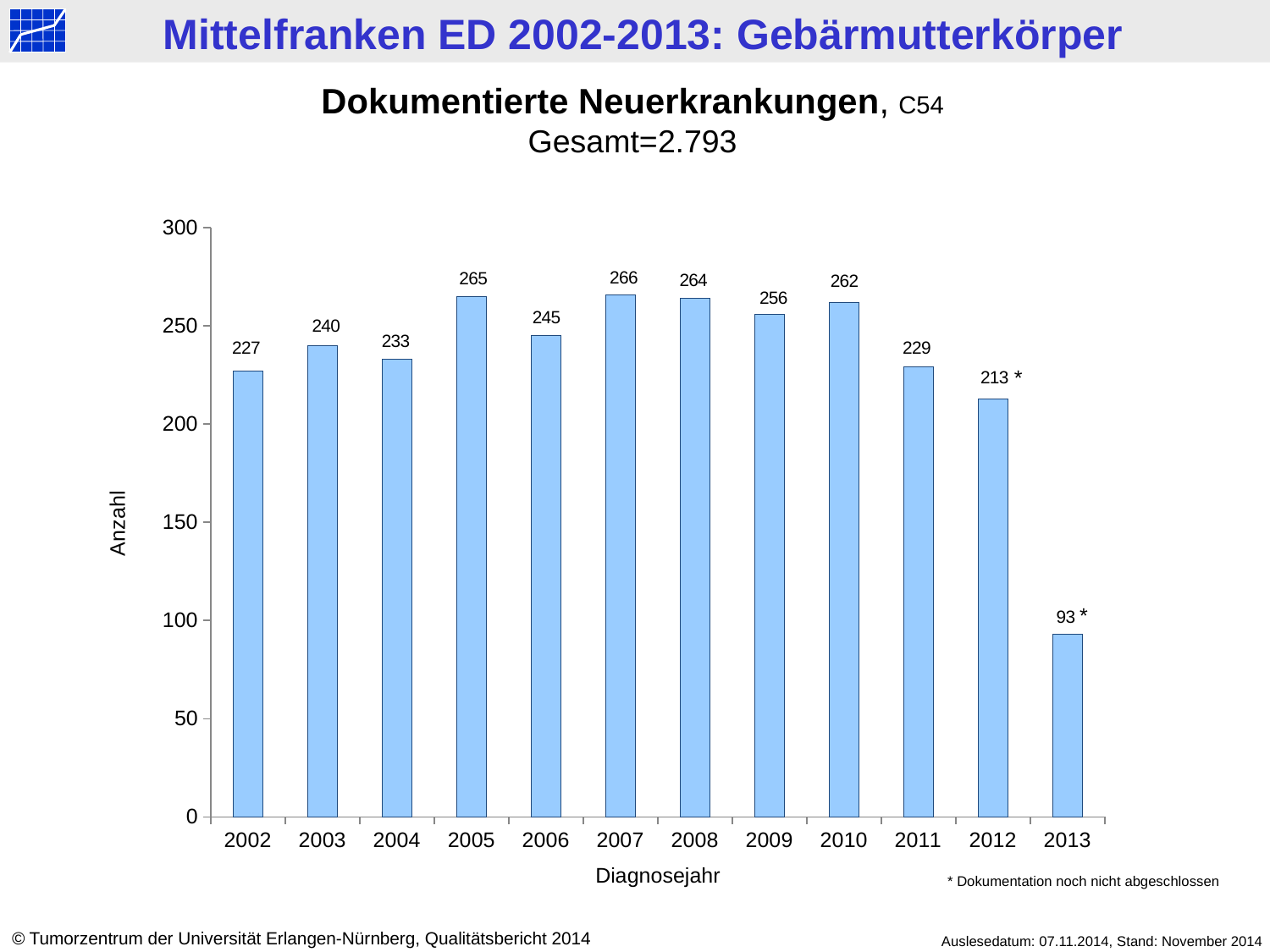
What is the label of the x axis? Diagnosejahr What total (Gesamt) is stated in the chart subtitle? 2.793 What is the difference between the values for 2007 and 2002? 39 Which year has a larger value, 2003 or 2009? 2009 Which year has the lowest number of documented new cases? 2013 What is the number of documented new cases (Anzahl) for the year 2005? 265 Is the value for 2013 greater or less than 100? less Which year has the highest number of documented new cases? 2007 What is the value shown for 2012? 213 Do the values rise or fall from 2010 to 2013? fall What kind of chart is shown on the slide? bar chart How many years (bars) are shown on the x axis? 12